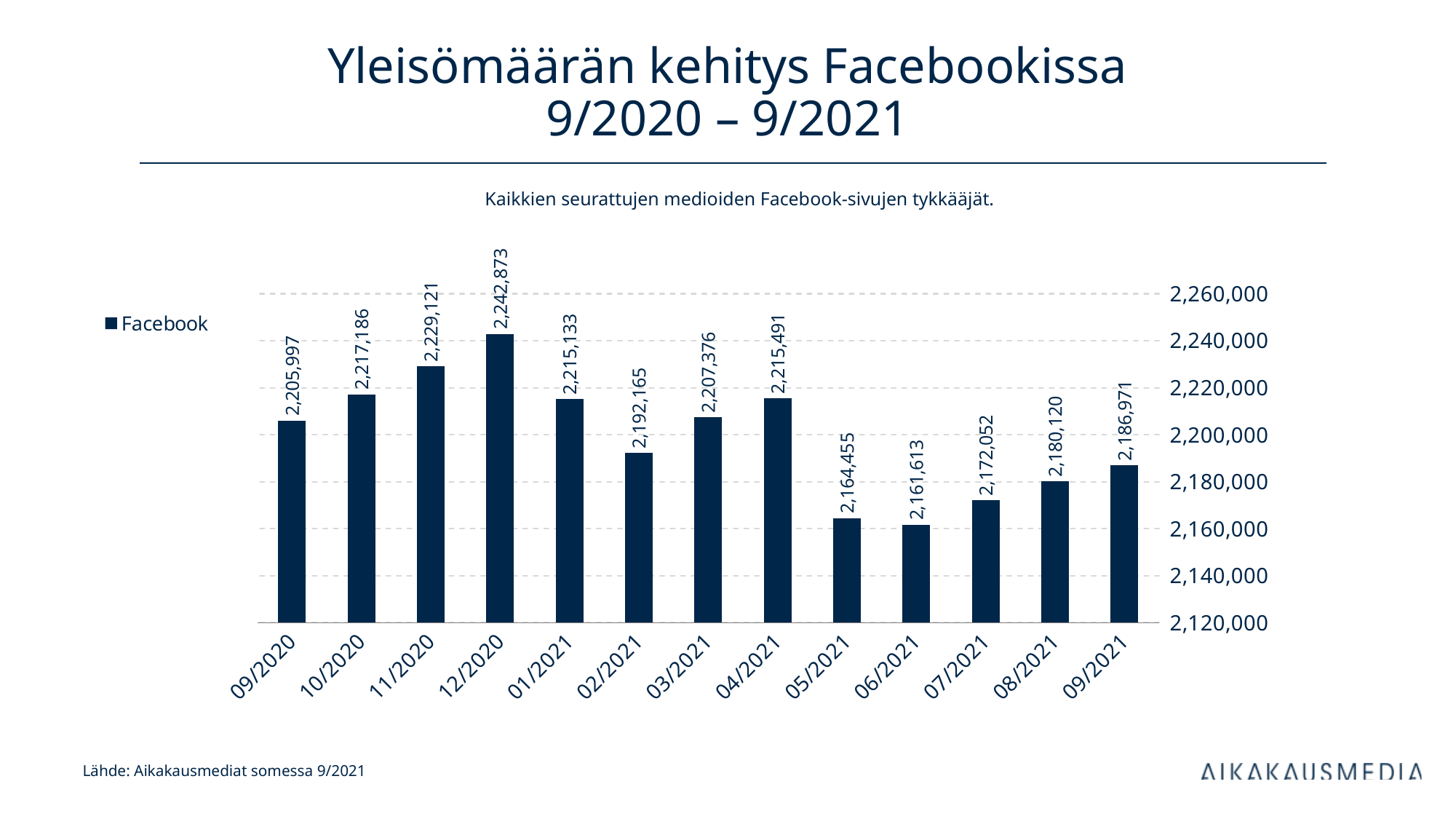
What is the value for 09/2021? 2,186,971 Which month has the highest value? 12/2020 What is the difference between the values for 12/2020 and 06/2021? 81,260 What is the value for 06/2021? 2,161,613 What is the value for 12/2020? 2,242,873 How many months are shown on the x axis? 13 What kind of chart is shown? bar chart How many series does the legend list? 1 Is the value for 05/2021 greater or less than 2,180,000? less Which month has the lowest value? 06/2021 Which is larger, the value for 09/2020 or the value for 09/2021? 09/2020 Do the values rise or fall from 12/2020 to 06/2021? fall